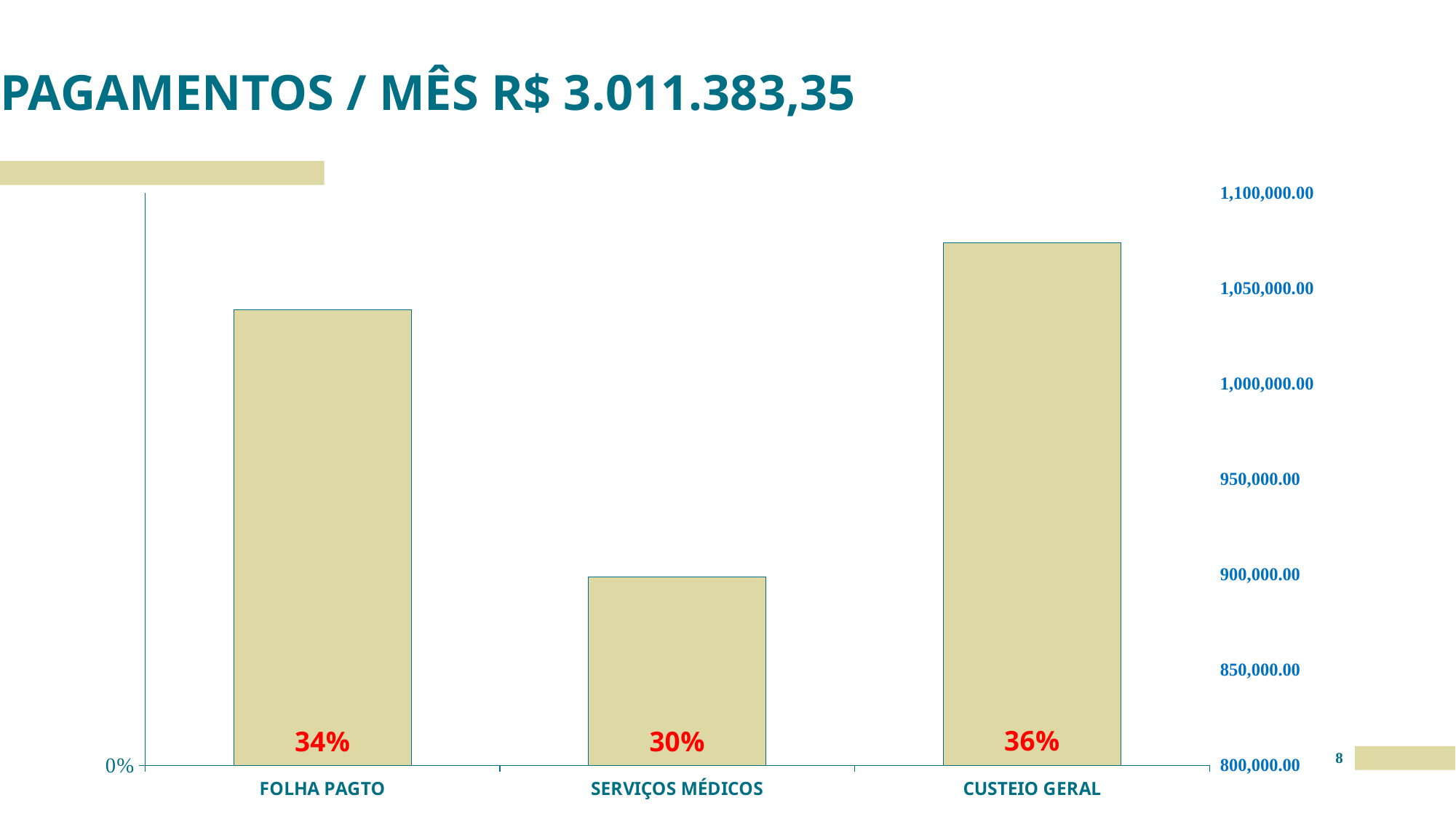
Is the value for SERVIÇOS MÉDICOS greater or less than 950,000.00? less Which is larger, the bar for FOLHA PAGTO or the bar for SERVIÇOS MÉDICOS? FOLHA PAGTO What kind of chart is shown on the slide? bar chart What is the title of the slide? PAGAMENTOS / MÊS R$ 3.011.383,35 What percentage label is shown on the SERVIÇOS MÉDICOS bar? 30% Which category has the highest bar? CUSTEIO GERAL What percentage label is shown on the FOLHA PAGTO bar? 34% Is the value for FOLHA PAGTO greater or less than 1,000,000.00? greater How many categories are shown on the chart? 3 What is the difference between the percentage labels of CUSTEIO GERAL and SERVIÇOS MÉDICOS? 6% What percentage label is shown on the CUSTEIO GERAL bar? 36% Which category has the lowest bar? SERVIÇOS MÉDICOS